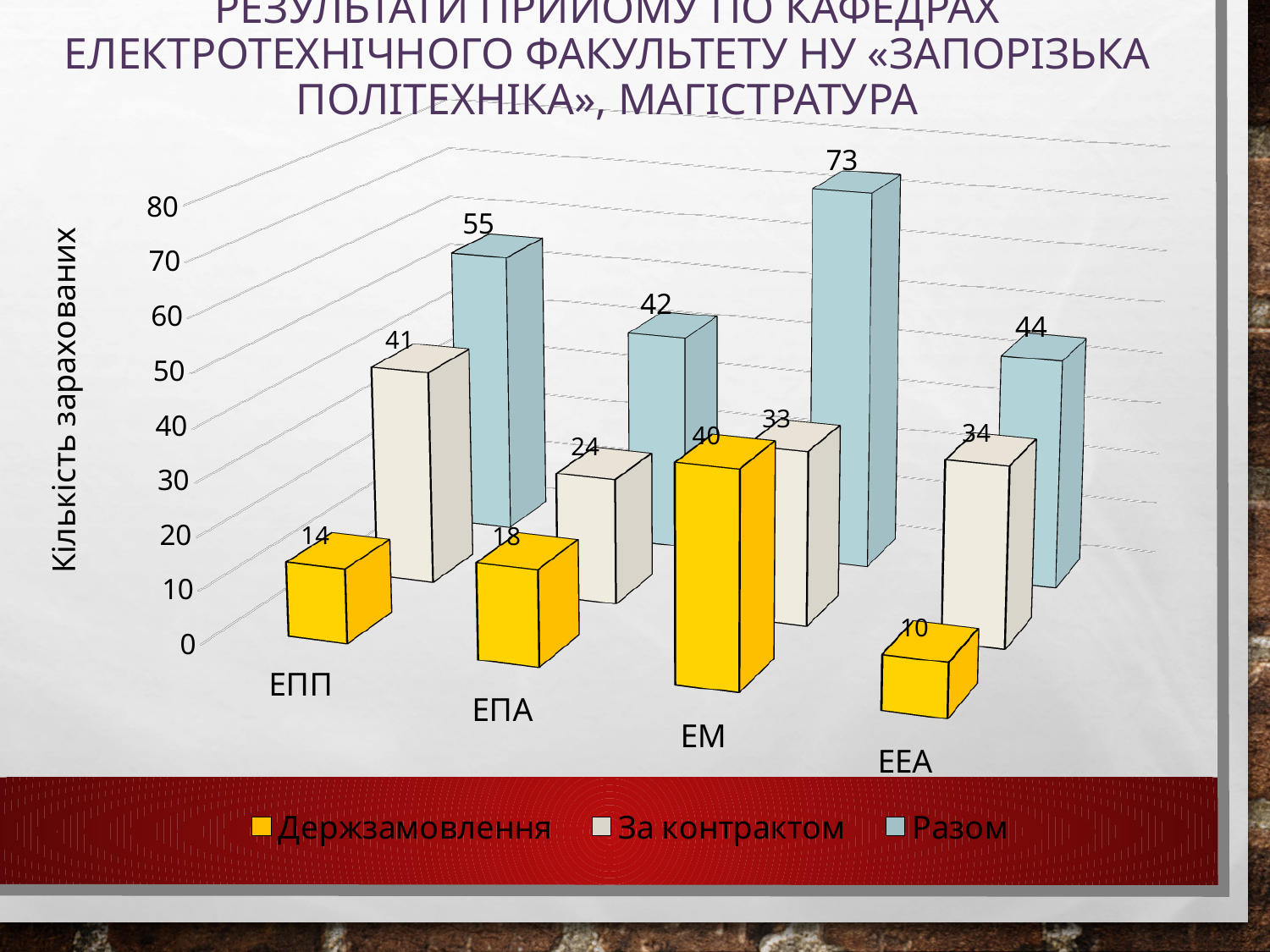
What is the label of the vertical axis? Кількість зарахованих What is the value of Держзамовлення for ЕМ? 40 How many categories are shown on the x axis? 4 What is the difference between the Разом values for ЕМ and ЕПА? 31 What is the value of Разом for ЕЕА? 44 What kind of chart is shown on the slide? Bar chart Which category has the highest Разом value? ЕМ What is the value of За контрактом for ЕПП? 41 Which is larger: За контрактом for ЕПА or За контрактом for ЕЕА? За контрактом for ЕЕА What is the value of Держзамовлення for ЕЕА? 10 How many series does the legend list? 3 Which category has the lowest Держзамовлення value? ЕЕА